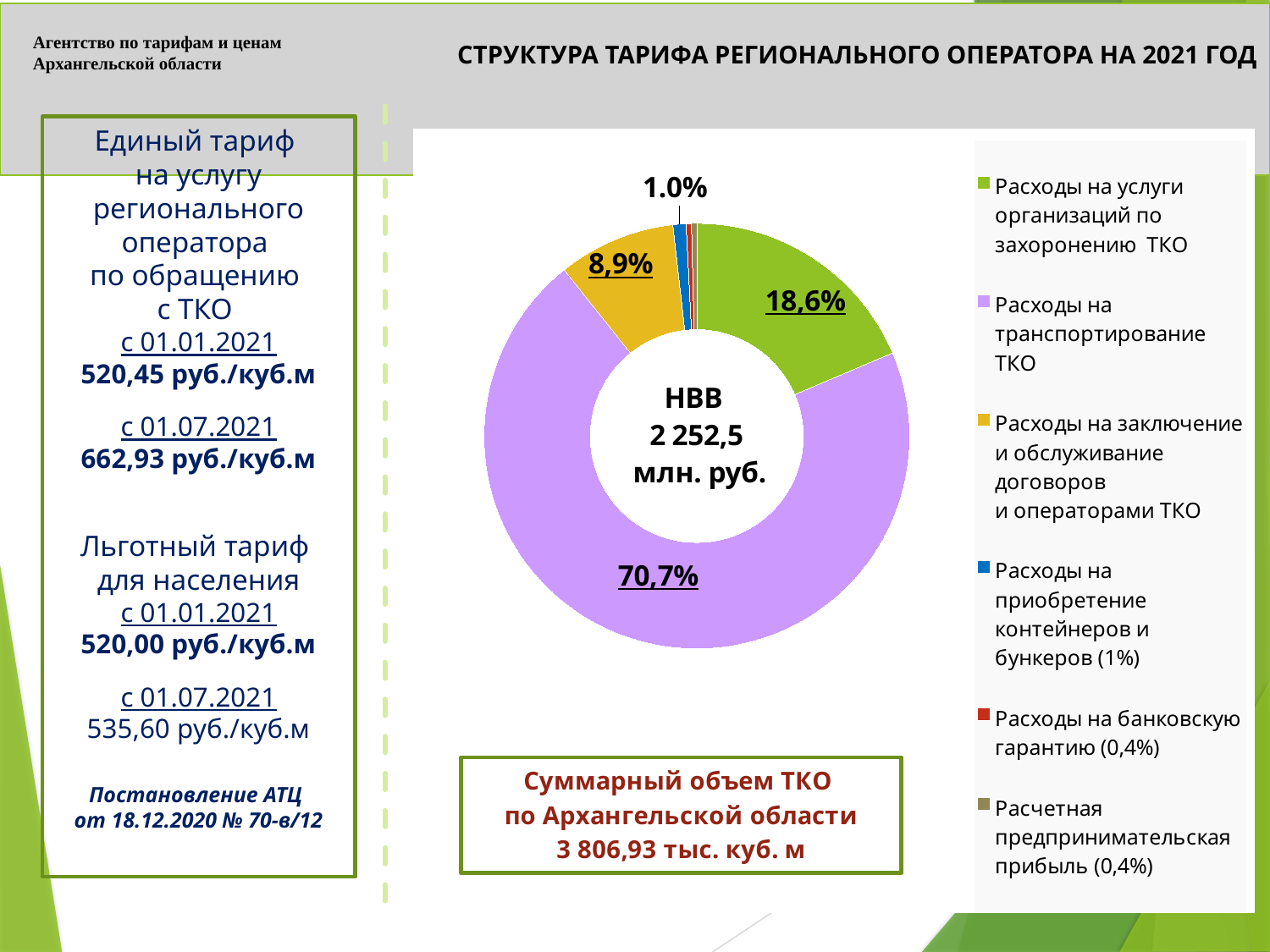
What colour is the slice for 'Расходы на транспортирование ТКО'? Purple Which category has the largest share of the chart? Расходы на транспортирование ТКО What share of the chart is taken by 'Расходы на приобретение контейнеров и бункеров'? 1.0% What share of the chart is taken by 'Расходы на транспортирование ТКО'? 70,7% Which is larger: the share for 'Расходы на услуги организаций по захоронению ТКО' or the share for 'Расходы на заключение и обслуживание договоров и операторами ТКО'? Расходы на услуги организаций по захоронению ТКО How many categories does the legend of the chart list? 6 What kind of chart is shown on the slide? Doughnut (pie) chart What share is given in the legend for 'Расходы на банковскую гарантию'? 0,4% What is the difference in percentage points between the share for 'Расходы на транспортирование ТКО' and the share for 'Расходы на услуги организаций по захоронению ТКО'? 52,1 percentage points What value is printed in the centre of the doughnut chart? НВВ 2 252,5 млн. руб.